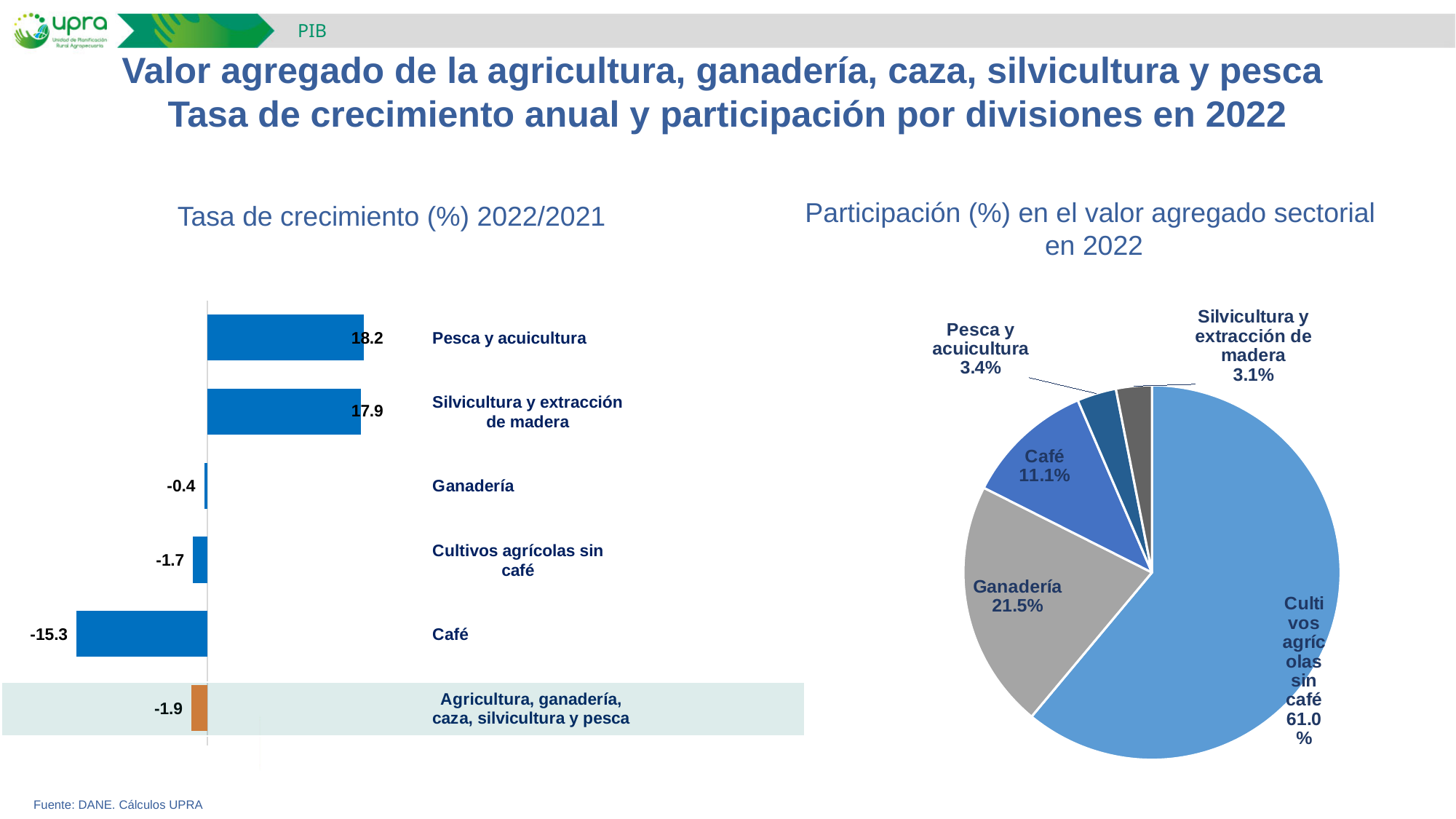
In the 'Participación (%) en el valor agregado sectorial en 2022' chart, which is larger, Pesca y acuicultura or Silvicultura y extracción de madera? Pesca y acuicultura In the 'Participación (%) en el valor agregado sectorial en 2022' chart, what share does Ganadería have? 21.5% What kind of chart is the 'Participación (%) en el valor agregado sectorial en 2022' chart? Pie chart What kind of chart is the 'Tasa de crecimiento (%) 2022/2021' chart? Bar chart In the 'Tasa de crecimiento (%) 2022/2021' chart, what is the value for Café? -15.3 In the 'Tasa de crecimiento (%) 2022/2021' chart, which category has the lowest value? Café In the 'Tasa de crecimiento (%) 2022/2021' chart, what is the value for Agricultura, ganadería, caza, silvicultura y pesca? -1.9 In the 'Tasa de crecimiento (%) 2022/2021' chart, which category has the highest value? Pesca y acuicultura In the 'Tasa de crecimiento (%) 2022/2021' chart, what is the value for Pesca y acuicultura? 18.2 In the 'Tasa de crecimiento (%) 2022/2021' chart, what is the difference between Pesca y acuicultura and Silvicultura y extracción de madera? 0.3 In the 'Participación (%) en el valor agregado sectorial en 2022' chart, which division has the largest share? Cultivos agrícolas sin café In the 'Tasa de crecimiento (%) 2022/2021' chart, how many categories are shown? 6